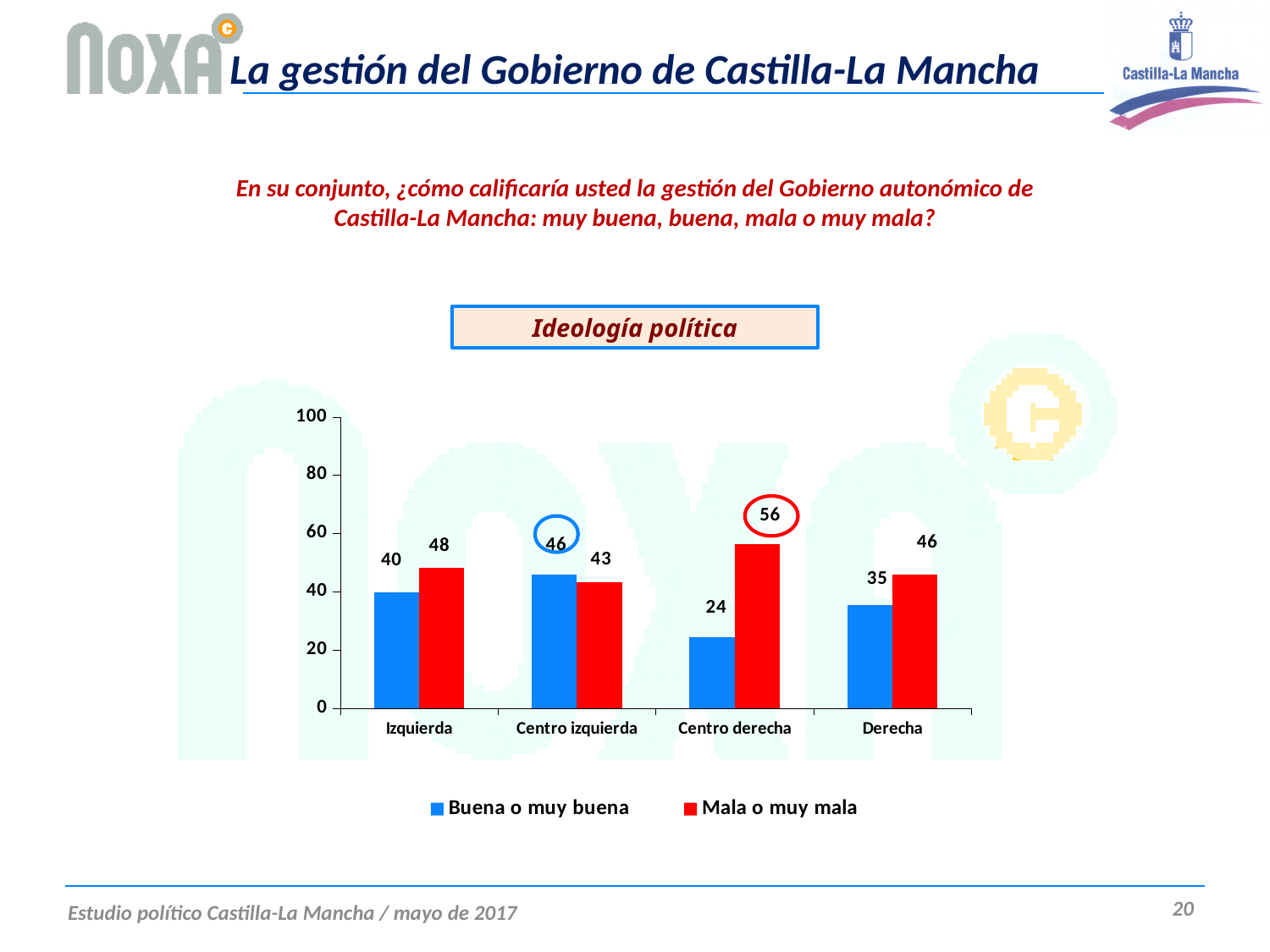
What colour represents the "Mala o muy mala" series? Red What is the value for "Buena o muy buena" in the Izquierda category? 40 Is the value for "Mala o muy mala" in the Izquierda category greater or less than 40? greater What is the difference between "Mala o muy mala" and "Buena o muy buena" in the Centro derecha category? 32 In the Centro izquierda category, which is larger: "Buena o muy buena" or "Mala o muy mala"? Buena o muy buena How many categories are shown on the x axis? 4 What kind of chart is shown on the slide? Bar chart How many series does the legend list? 2 Which category has the highest value for "Mala o muy mala"? Centro derecha Which category has the lowest value for "Buena o muy buena"? Centro derecha What is the value for "Mala o muy mala" in the Centro derecha category? 56 What is the value for "Buena o muy buena" in the Derecha category? 35